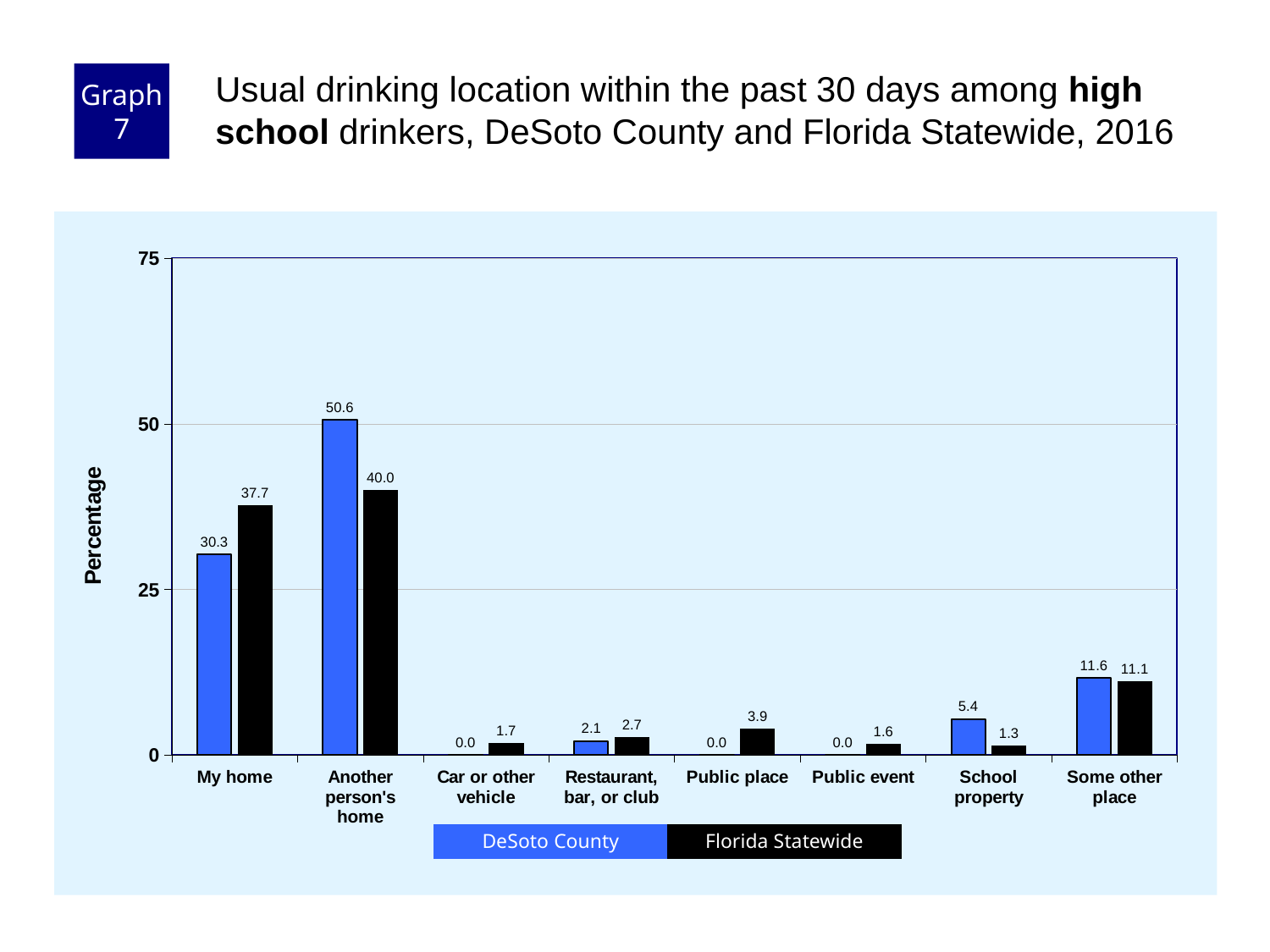
How many series does the legend list? 2 Which category has the highest DeSoto County value? Another person's home What is the Florida Statewide value for "My home"? 37.7 What is the DeSoto County value for "School property"? 5.4 What is the difference between the DeSoto County and Florida Statewide values for "Another person's home"? 10.6 What kind of chart is shown on the slide? Bar chart Is the DeSoto County value for "Another person's home" greater or less than 50? greater Which category has the lowest Florida Statewide value? School property How many categories are shown on the x axis? 8 Which is larger for "My home": DeSoto County or Florida Statewide? Florida Statewide What is the label on the y axis? Percentage What is the DeSoto County value for "Another person's home"? 50.6